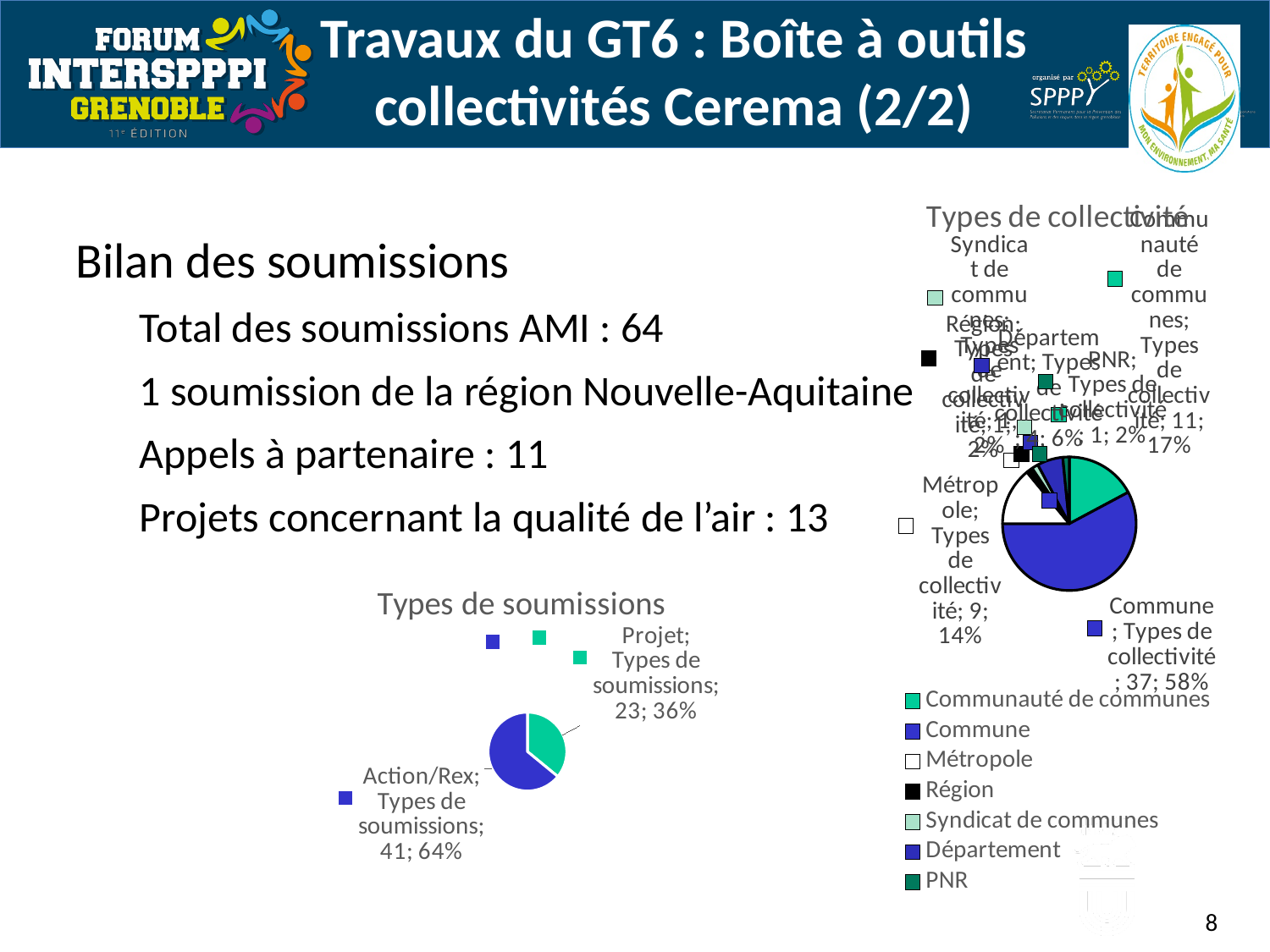
In the 'Types de collectivité' chart, what share of the pie does Commune represent? 58% In the 'Types de collectivité' chart, what is the value for Commune? 37 In the 'Types de collectivité' chart, what is the value for Communauté de communes? 11 How many entries does the legend of the 'Types de collectivité' chart list? 7 In the 'Types de soumissions' chart, what share of the pie does Projet represent? 36% What type of chart is the 'Types de soumissions' chart? pie chart In the 'Types de soumissions' chart, what is the value for Action/Rex? 41 In the 'Types de collectivité' chart, which is larger: Communauté de communes or Métropole? Communauté de communes In the 'Types de collectivité' chart, what share of the pie does Métropole represent? 14% In the 'Types de soumissions' chart, what is the difference between the Action/Rex and Projet values? 18 How many categories does the 'Types de soumissions' chart show? 2 In the 'Types de soumissions' chart, which category is the largest? Action/Rex